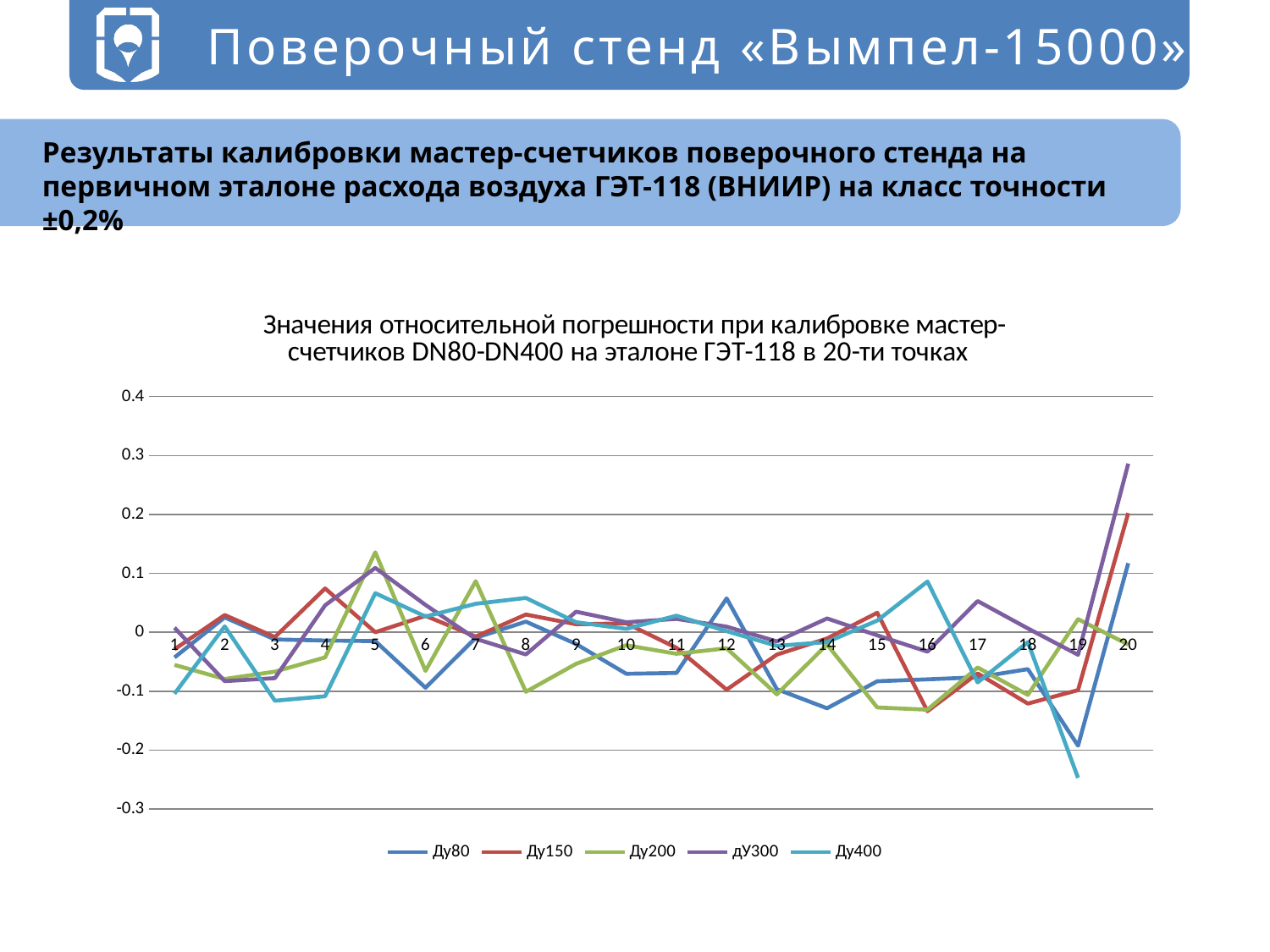
Which series reaches the lowest value anywhere on the chart? Ду400 Is the value for Ду400 at point 19 greater or less than -0.2? less What kind of chart is shown on the slide? line chart Which series has the highest value at point 20? дУ300 Is the value for дУ300 at point 20 greater or less than 0.2? greater What is the title of the chart? Значения относительной погрешности при калибровке мастер-счетчиков DN80-DN400 на эталоне ГЭТ-118 в 20-ти точках At point 5, which is larger: the value for Ду200 or the value for Ду80? Ду200 Is the value for Ду80 at point 14 greater or less than -0.1? less How many series does the legend list? 5 How many points are plotted along the x axis for each series? 20 Which series are listed in the legend? Ду80, Ду150, Ду200, дУ300, Ду400